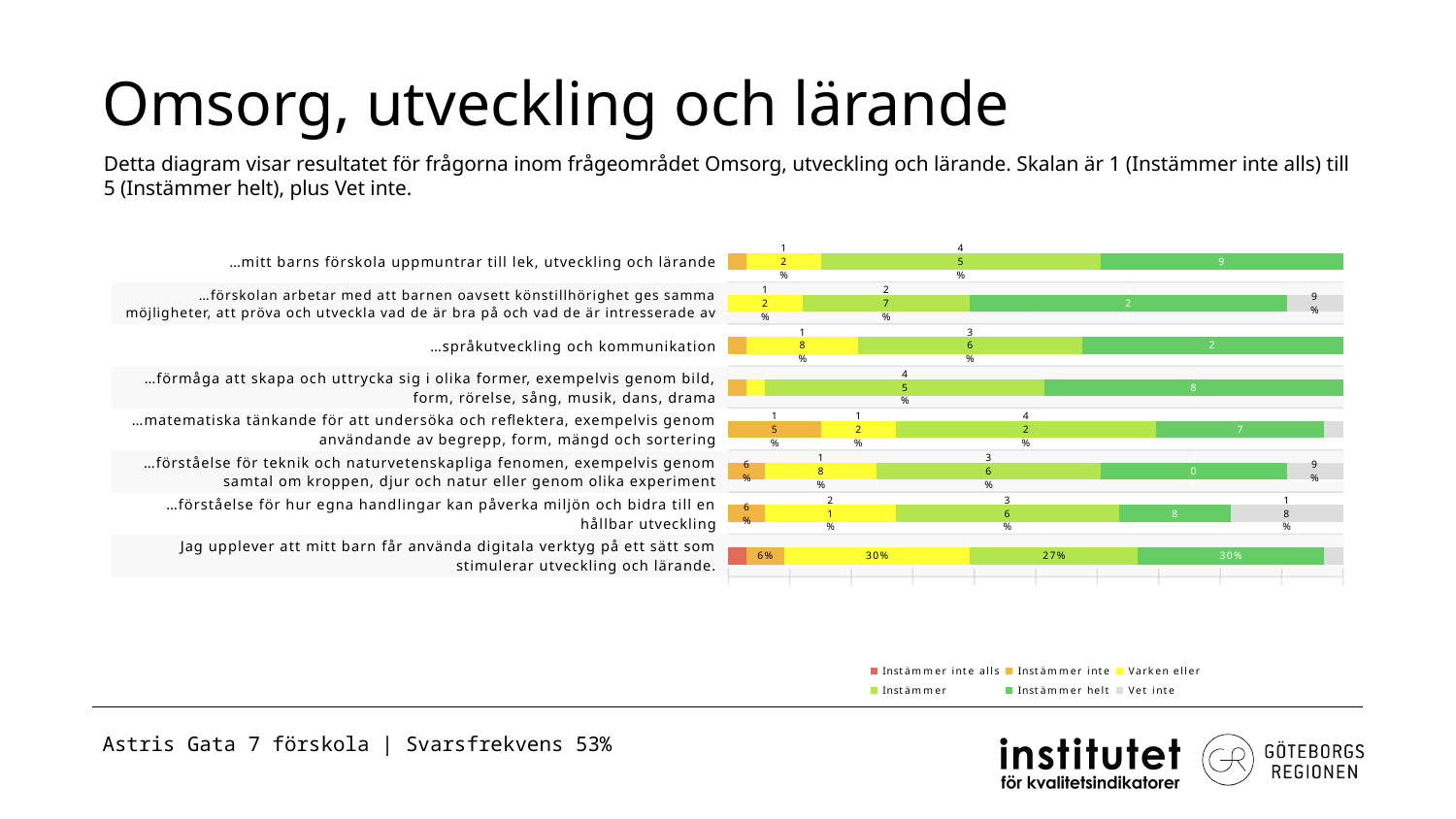
What kind of chart is shown on the slide? Bar chart (stacked horizontal bars) What colour does the legend use for "Vet inte"? Grey For the question "Jag upplever att mitt barn får använda digitala verktyg på ett sätt som stimulerar utveckling och lärande", what share answered "Instämmer helt"? 30% How many questions (categories) are plotted in the chart? 8 How many series does the legend list? 6 In the row "Jag upplever att mitt barn får använda digitala verktyg...", what is the difference between the "Instämmer helt" share and the "Instämmer" share? 3% In the row "Jag upplever att mitt barn får använda digitala verktyg...", which is larger: the "Instämmer" share or the "Varken eller" share? Varken eller For the question "Jag upplever att mitt barn får använda digitala verktyg på ett sätt som stimulerar utveckling och lärande", what share answered "Varken eller"? 30% Which question has the largest "Instämmer helt" (dark green) segment? …förskolan arbetar med att barnen oavsett könstillhörighet ges samma möjligheter, att pröva och utveckla vad de är bra på och vad de är intresserade av Which question has the largest "Varken eller" (yellow) segment? Jag upplever att mitt barn får använda digitala verktyg på ett sätt som stimulerar utveckling och lärande For the question "Jag upplever att mitt barn får använda digitala verktyg på ett sätt som stimulerar utveckling och lärande", what share answered "Instämmer"? 27%